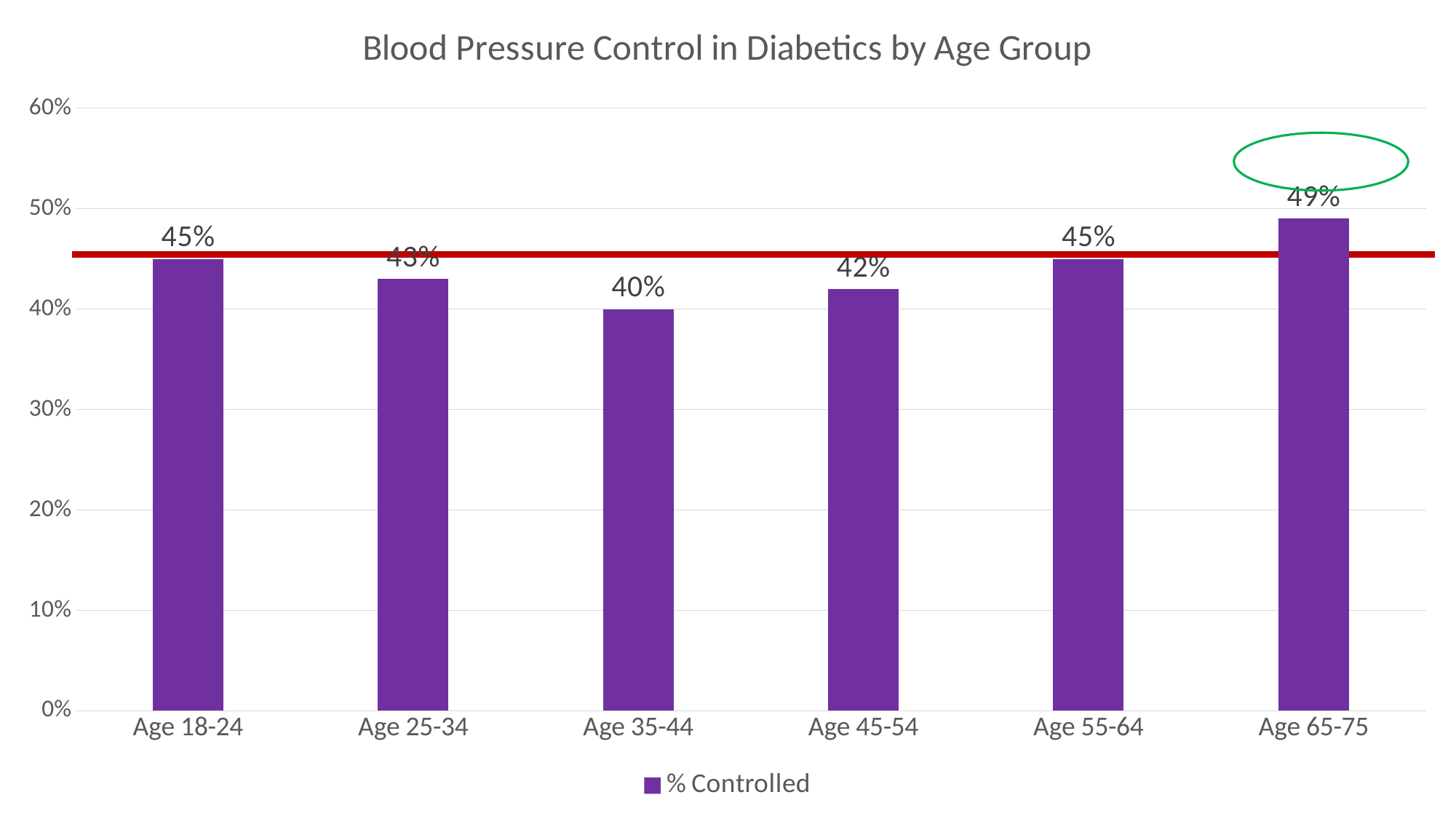
What is the % Controlled value for Age 65-75? 49% Which age group has the highest % Controlled? Age 65-75 What is the % Controlled value for Age 35-44? 40% Is the value for Age 65-75 greater or less than 40%? greater How many age groups are shown on the chart? 6 Which age group has the lowest % Controlled? Age 35-44 What kind of chart is shown on the slide? Bar chart What is the difference in % Controlled between Age 65-75 and Age 35-44? 9% Which has a higher % Controlled, Age 25-34 or Age 55-64? Age 55-64 What is the title of the chart? Blood Pressure Control in Diabetics by Age Group What is the % Controlled value for Age 45-54? 42% How many series does the legend list? 1